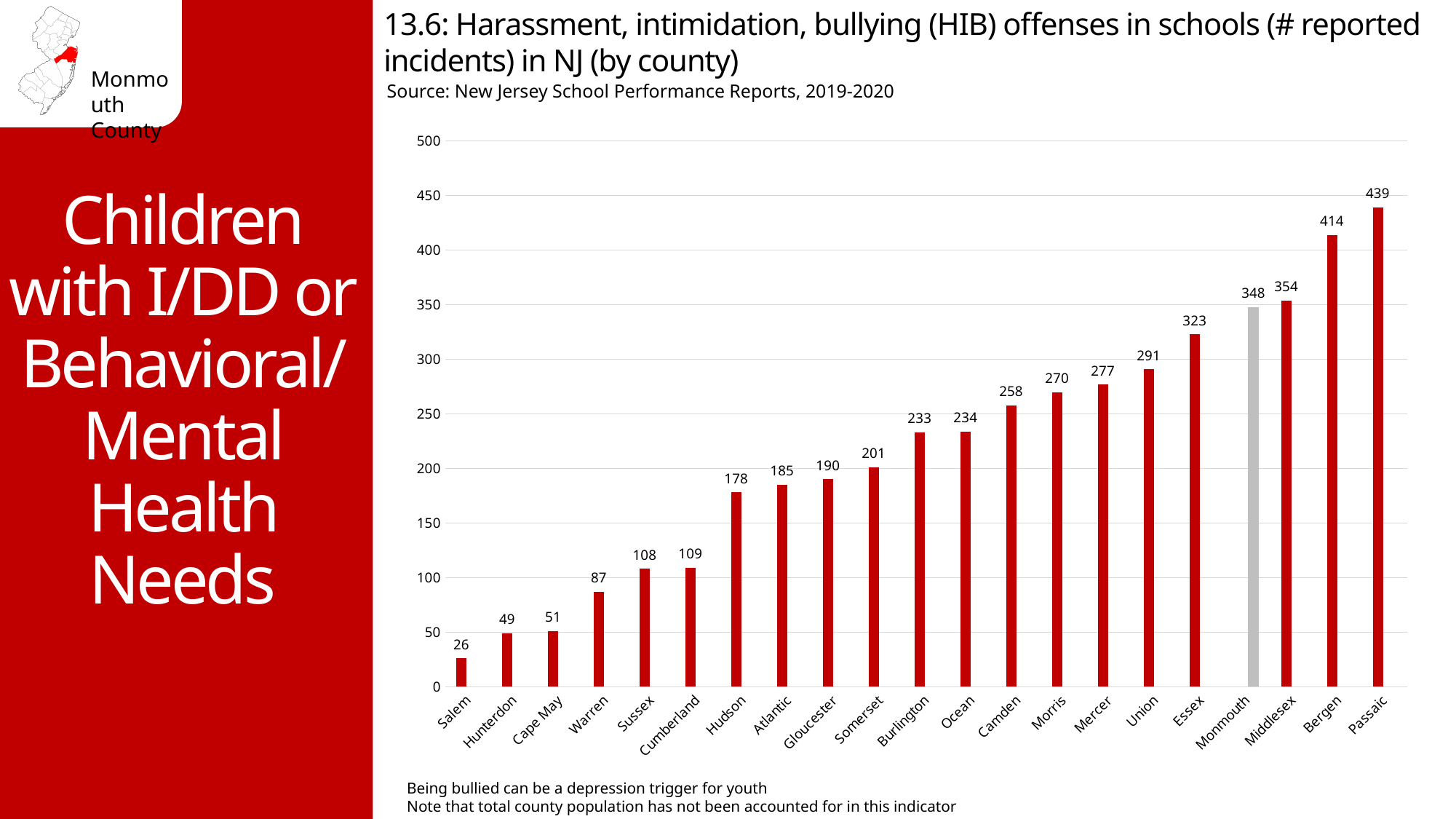
What is the difference in reported HIB incidents between Passaic and Bergen? 25 Which county's bar is shown in grey rather than red? Monmouth Which county has the lowest number of reported HIB incidents? Salem How many counties are shown on the chart? 21 Which county has more reported HIB incidents, Essex or Union? Essex What is the number of reported HIB incidents for Hudson County? 178 Do the values rise or fall moving from left to right along the x axis? Rise Which county has the highest number of reported HIB incidents? Passaic What is the difference in reported HIB incidents between Monmouth and Salem? 322 What kind of chart is shown on the slide? Bar chart What is the number of reported HIB incidents for Monmouth County? 348 Is the value for Camden greater or less than 250? greater